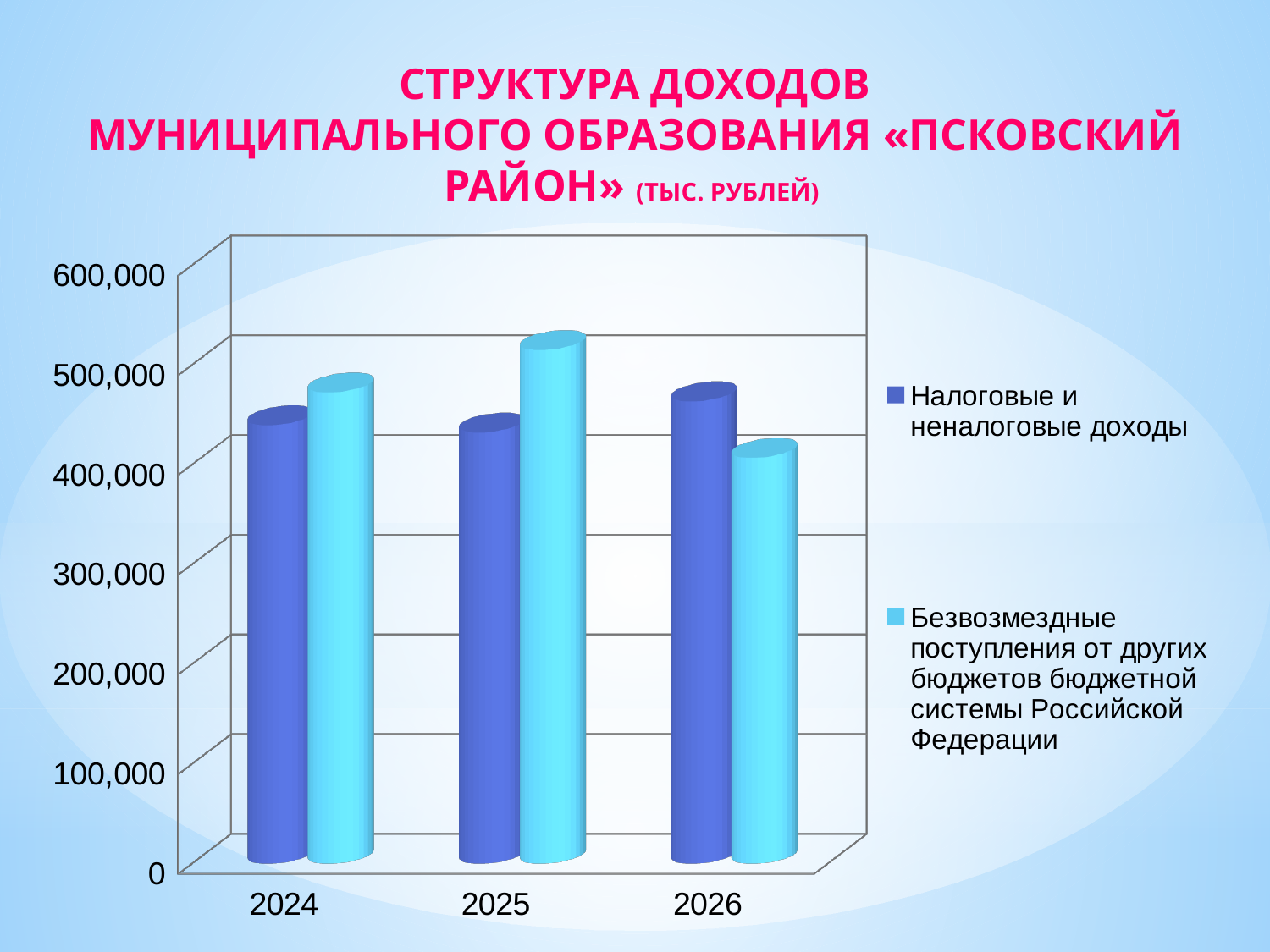
How many series does the legend list? 2 In which year is the value for «Безвозмездные поступления от других бюджетов бюджетной системы Российской Федерации» the lowest? 2026 Is the value for «Безвозмездные поступления» in 2025 greater or less than 500,000? greater What unit of measurement is given in the chart title? тыс. рублей In which year is the value for «Безвозмездные поступления от других бюджетов бюджетной системы Российской Федерации» the highest? 2025 Is the value for «Налоговые и неналоговые доходы» in 2024 greater or less than 500,000? less What kind of chart is shown on the slide? bar chart In 2026, which series has the larger value: «Налоговые и неналоговые доходы» or «Безвозмездные поступления»? Налоговые и неналоговые доходы In which year is the value for «Налоговые и неналоговые доходы» the highest? 2026 Is the value for «Налоговые и неналоговые доходы» in 2025 greater or less than 400,000? greater How many years are shown on the x axis? 3 In 2025, which series has the larger value: «Налоговые и неналоговые доходы» or «Безвозмездные поступления»? Безвозмездные поступления